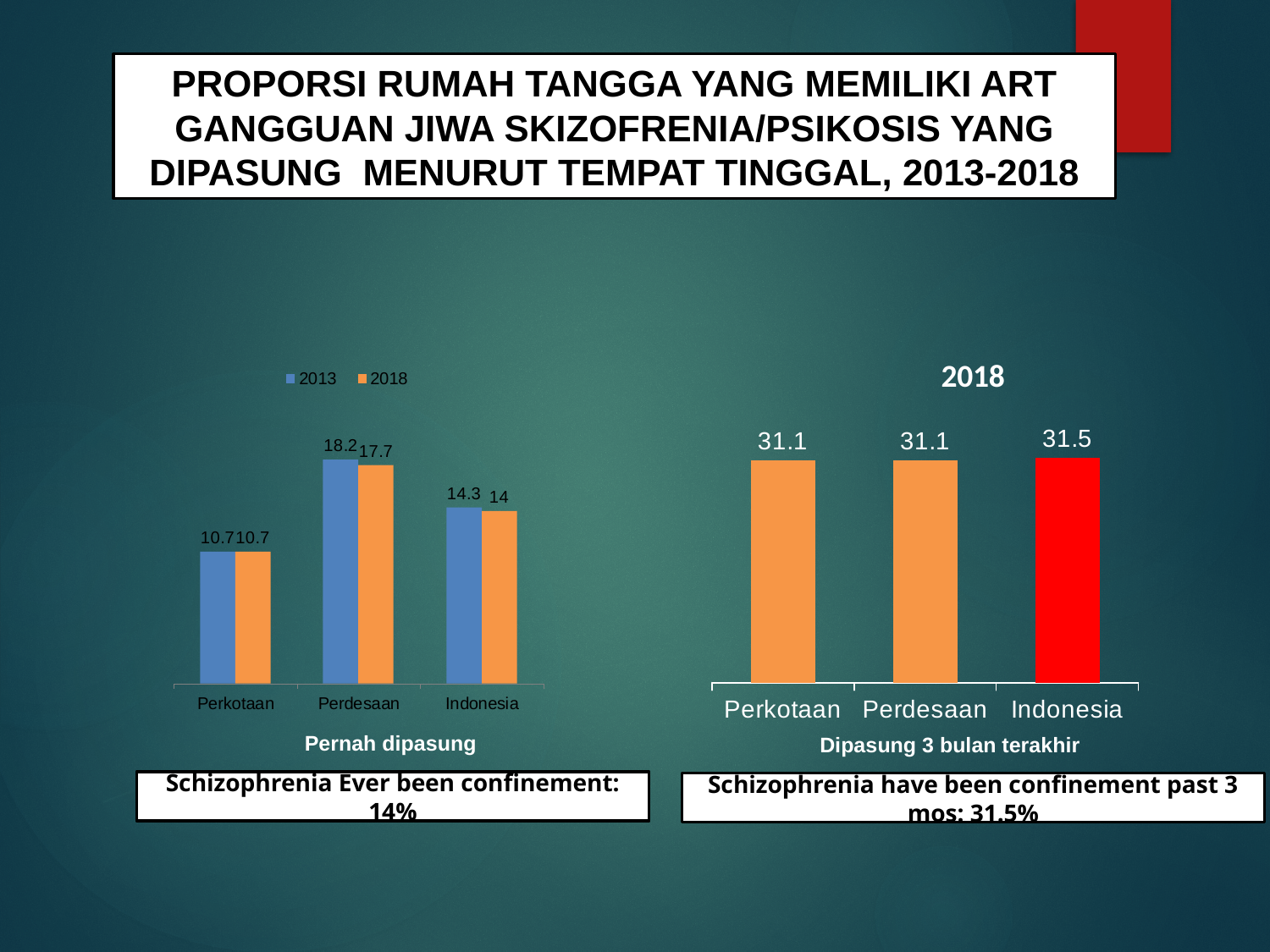
In the left chart (Pernah dipasung), what is the 2018 value for Indonesia? 14 In the left chart (Pernah dipasung), what is the difference between the 2013 and 2018 values for Perdesaan? 0.5 In the left chart (Pernah dipasung), what is the 2013 value for Perdesaan? 18.2 In the right chart (Dipasung 3 bulan terakhir), what is the value for Indonesia? 31.5 In the left chart (Pernah dipasung), how many series does the legend list? 2 What type of chart is the right chart (Dipasung 3 bulan terakhir)? Bar chart In the left chart (Pernah dipasung), what is the 2018 value for Perkotaan? 10.7 In the left chart (Pernah dipasung), which category has the highest 2018 value? Perdesaan In the right chart (Dipasung 3 bulan terakhir), what is the value for Perkotaan? 31.1 In the left chart (Pernah dipasung), which category has the lowest 2013 value? Perkotaan In the right chart (Dipasung 3 bulan terakhir), how many categories are shown on the x axis? 3 In the left chart (Pernah dipasung), is the 2013 value for Perdesaan larger or smaller than the 2013 value for Indonesia? larger